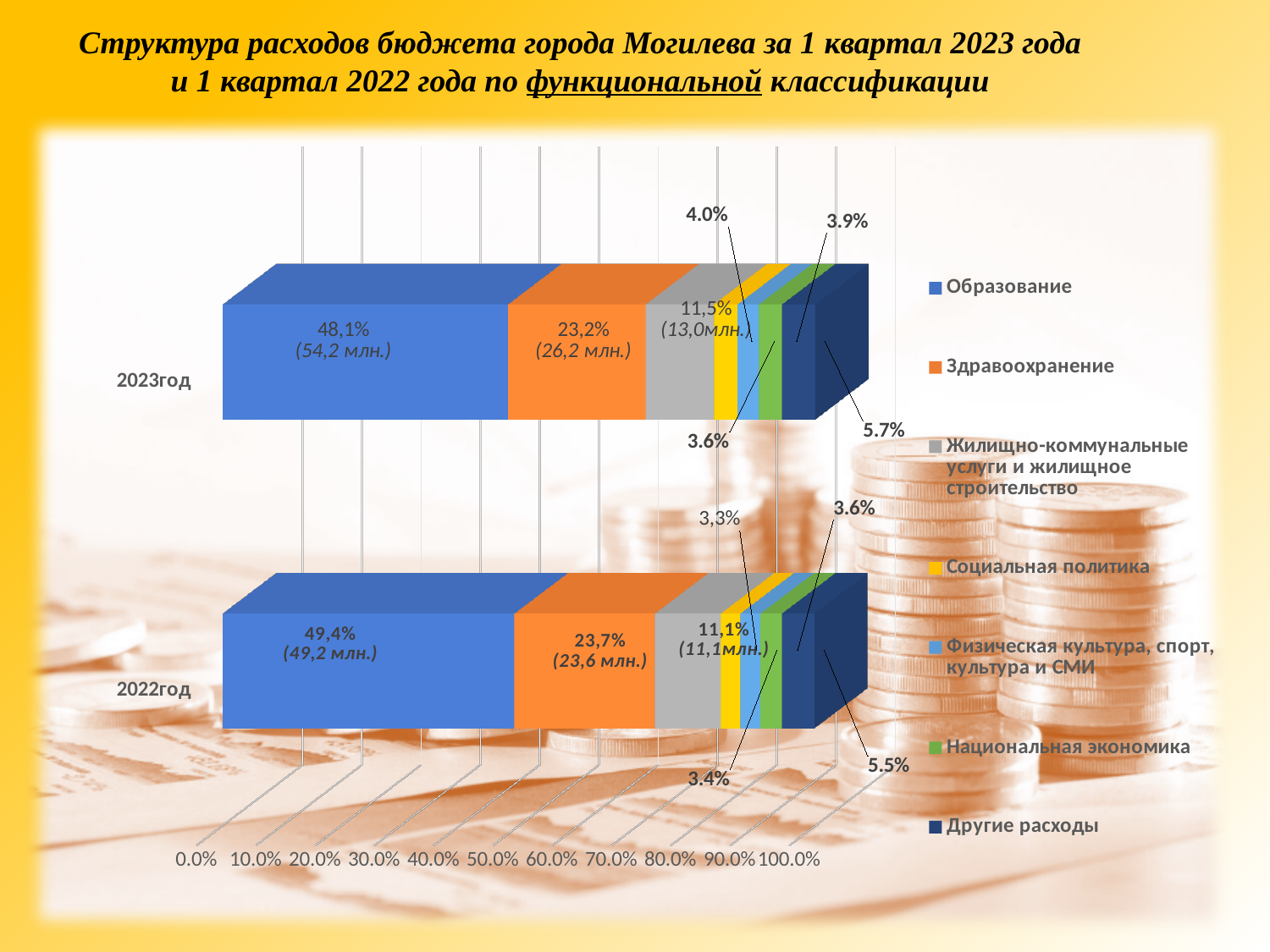
What share of the 2023 budget expenditures went to Образование? 48,1% What is the difference in millions between the Здравоохранение amounts for 2023 and 2022? 2,6 млн. What amount in millions is shown for Жилищно-коммунальные услуги и жилищное строительство in 2023? 13,0 млн. What share is shown for Жилищно-коммунальные услуги и жилищное строительство in 2022? 11,1% How many years (bars) are shown in the chart? 2 Which year had the larger share for Образование, 2023 or 2022? 2022 Which expenditure category has the largest share in the 2023 bar? Образование What colour represents Здравоохранение in the legend? Orange How many series does the legend list? 7 What share of the 2022 budget expenditures went to Здравоохранение? 23,7% What type of chart is shown on the slide? Stacked bar chart By how many percentage points did the share of Образование in 2022 exceed that in 2023? 1,3